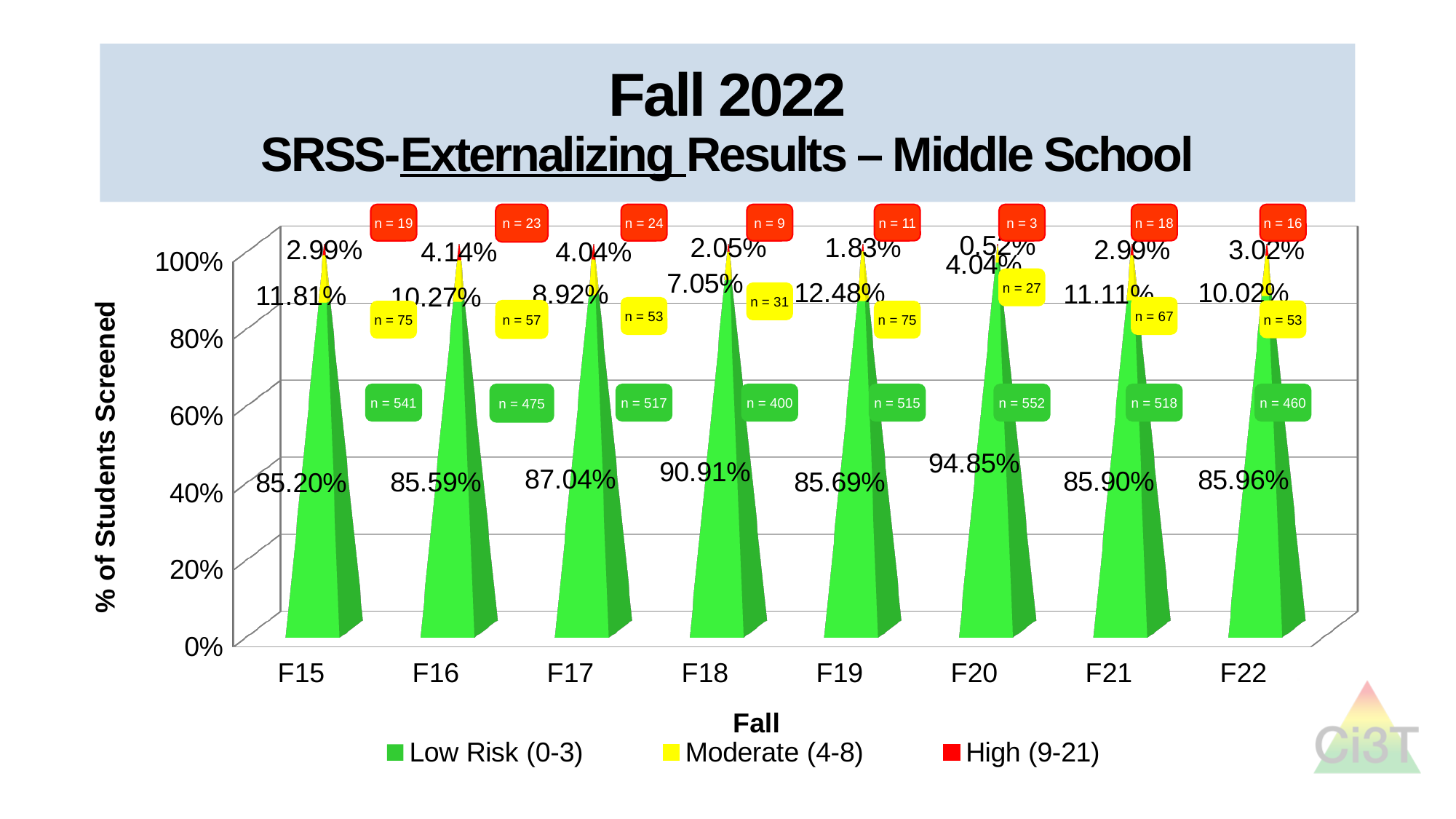
Which fall has the highest Low Risk (0-3) percentage? F20 Which fall has the highest Moderate (4-8) percentage? F19 What is the Low Risk (0-3) percentage for F18? 90.91% What is the difference between the Low Risk (0-3) percentages for F20 and F15? 9.65% Which is larger, the Moderate (4-8) percentage for F15 or for F21? F15 How many fall semesters are shown on the x axis? 8 Which fall has the lowest High (9-21) percentage? F20 What is the High (9-21) percentage for F16? 4.14% What is the label of the y axis? % of Students Screened What is the Moderate (4-8) percentage for F19? 12.48% How many students were in the Low Risk (0-3) group in F20 (the n value)? n = 552 How many series does the legend list? 3